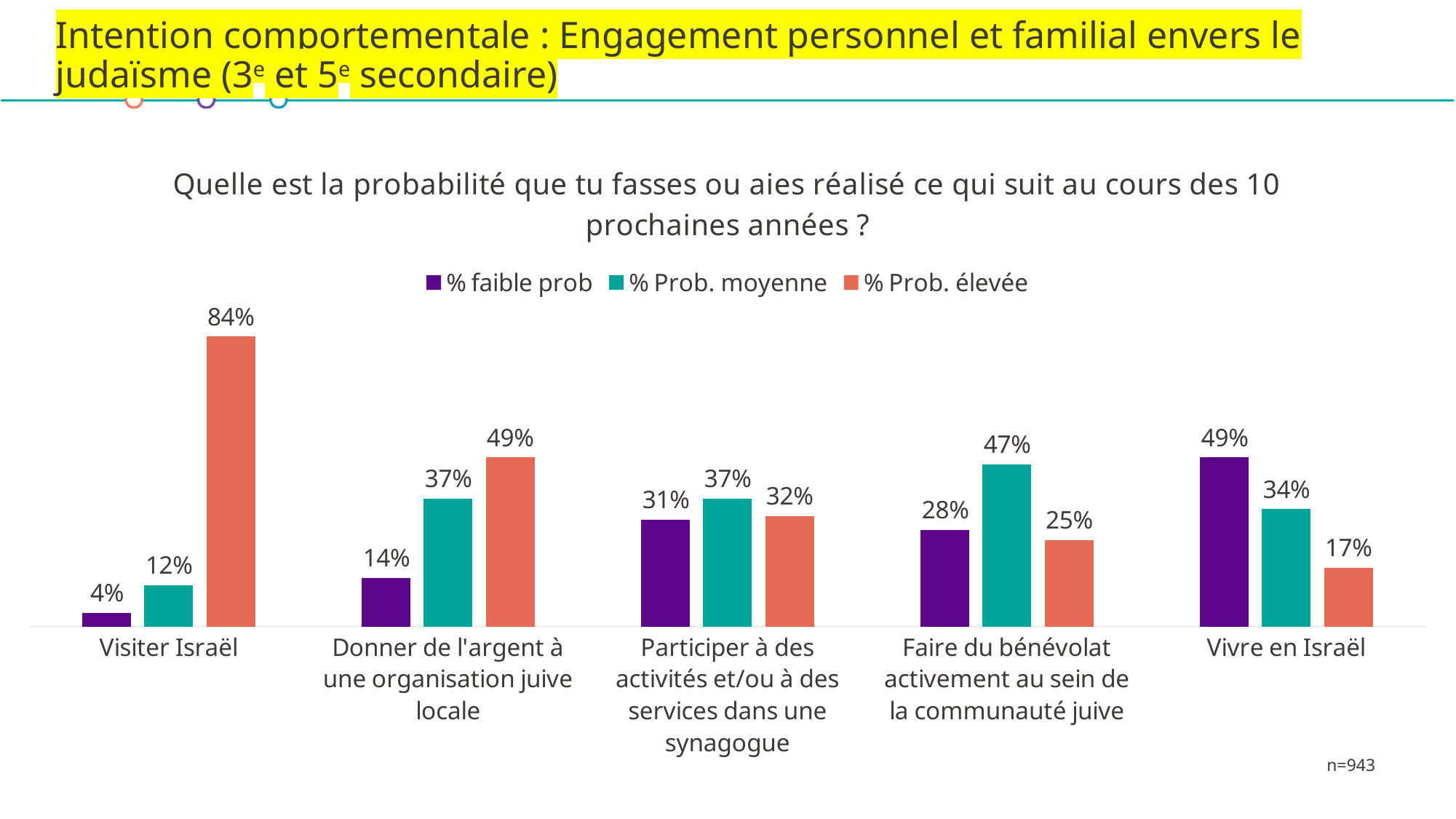
What is the difference between '% Prob. élevée' and '% faible prob' for 'Visiter Israël'? 80% Which is larger for 'Vivre en Israël': '% faible prob' or '% Prob. élevée'? % faible prob How many categories are shown on the x axis? 5 Which category has the highest '% Prob. élevée' value? Visiter Israël What is the value of '% Prob. moyenne' for 'Faire du bénévolat activement au sein de la communauté juive'? 47% What is the sample size noted on the slide? n=943 Which category has the lowest '% faible prob' value? Visiter Israël What kind of chart is shown on the slide? Bar chart What colour represents the '% Prob. moyenne' series? Teal How many series does the legend list? 3 What is the value of '% Prob. élevée' for 'Visiter Israël'? 84% What is the value of '% faible prob' for 'Vivre en Israël'? 49%